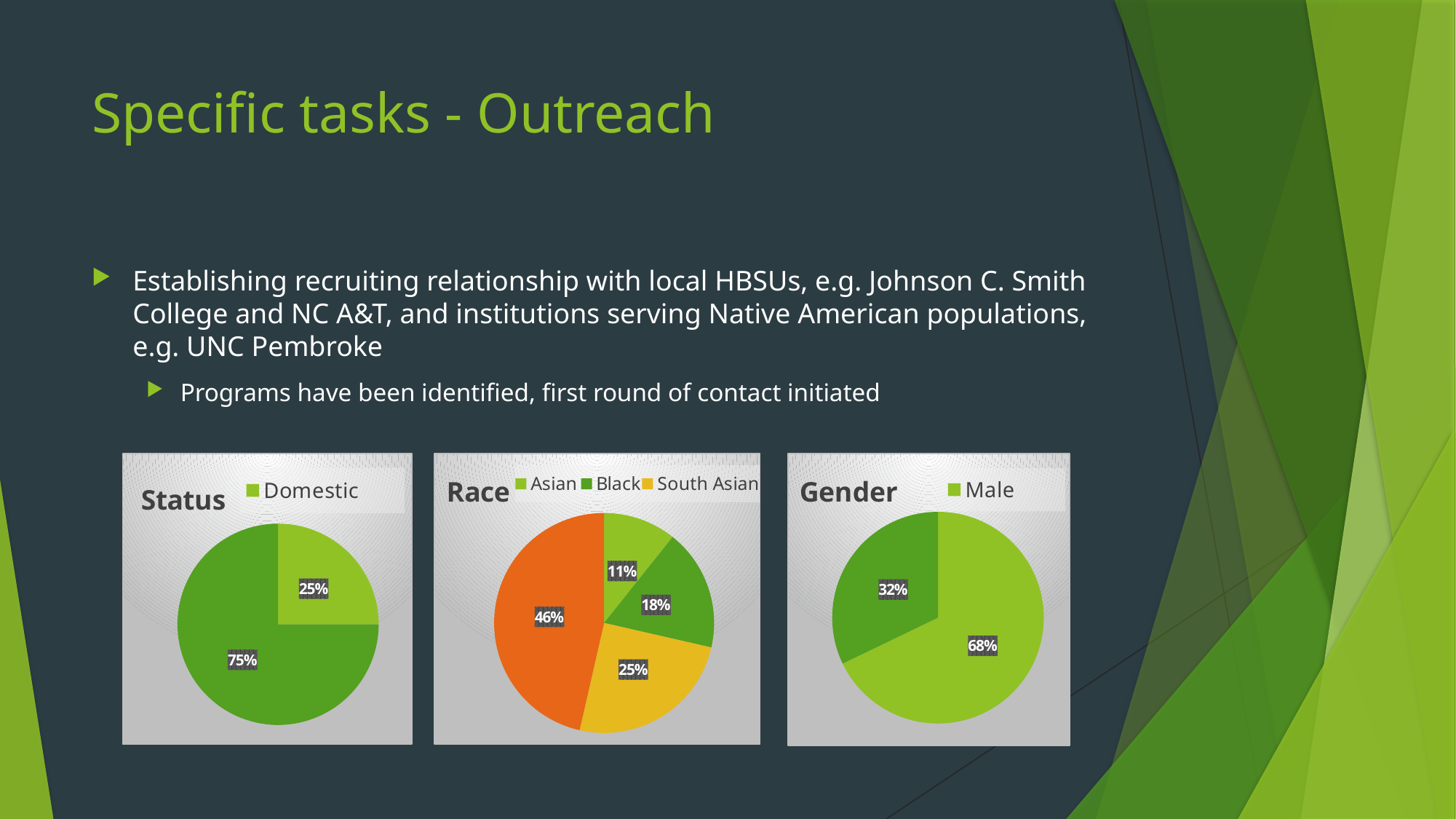
In the Race chart, what percentage is Asian? 11% In the Race chart, what is the difference in percentage points between South Asian and Asian? 14 How many charts are shown on the slide? 3 In the Race chart, what percentage is Black? 18% What type of chart is the Gender chart? Pie chart In the Status chart, what percentage is Domestic? 25% In the Race chart, which of the labelled legend categories (Asian, Black, South Asian) has the smallest share? Asian In the Race chart, which is larger, Black or South Asian? South Asian In the Race chart, what percentage is South Asian? 25% In the Race chart, how many slices does the pie have? 4 In the Gender chart, what is the largest slice's percentage? 68% In the Gender chart, what percentage is Male? 68%